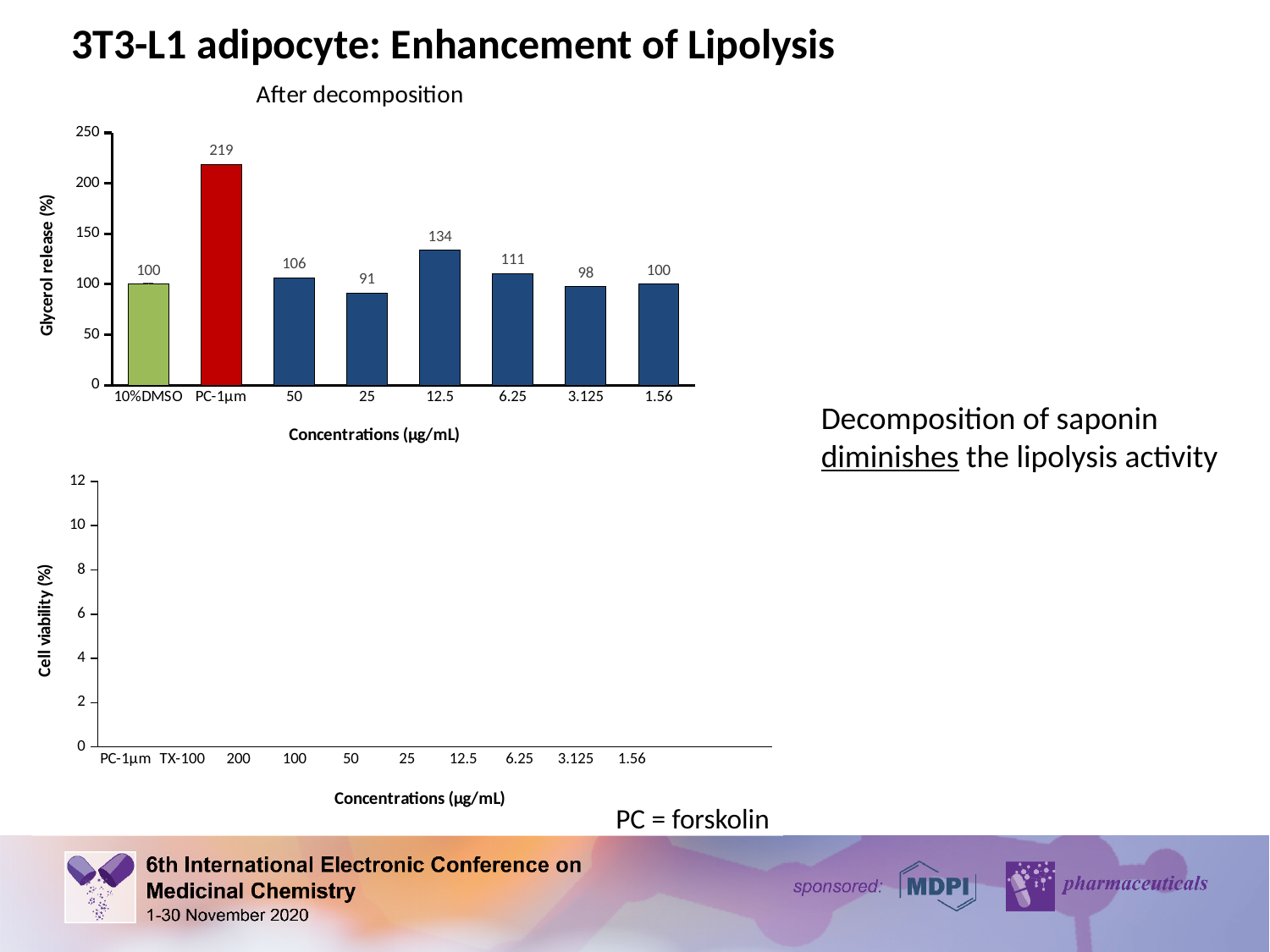
In the 'After decomposition' chart, which has a larger glycerol release value: 12.5 µg/mL or 6.25 µg/mL? 12.5 What is the y-axis label of the 'After decomposition' chart? Glycerol release (%) What kind of chart is the 'After decomposition' chart? bar chart In the 'After decomposition' chart, is the glycerol release value for PC-1µm greater or less than 200? greater In the 'After decomposition' chart, what is the difference between the glycerol release for PC-1µm and for 10%DMSO? 119 In the 'After decomposition' chart, which category has the highest glycerol release? PC-1µm In the 'After decomposition' chart, what is the glycerol release value for PC-1µm? 219 In the 'After decomposition' chart, which category has the lowest glycerol release? 25 In the 'After decomposition' chart, what is the glycerol release value at 25 µg/mL? 91 How many categories are shown on the x axis of the 'After decomposition' chart? 8 In the 'After decomposition' chart, what is the glycerol release value at 12.5 µg/mL? 134 In the 'After decomposition' chart, what is the glycerol release value at 3.125 µg/mL? 98